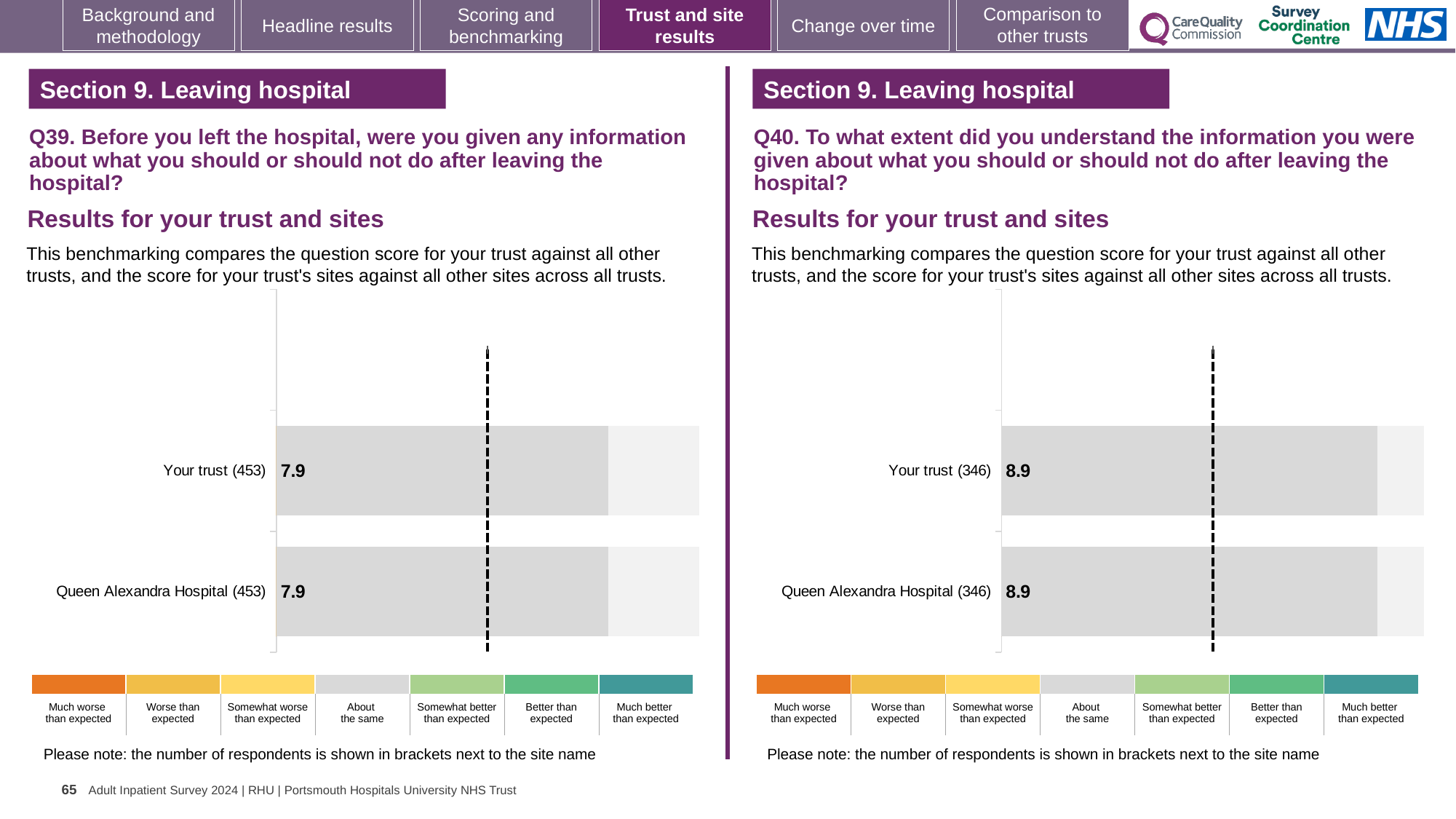
In the Q40 chart on the right, how many respondents are shown in brackets next to Queen Alexandra Hospital? 346 In the Q39 chart on the left, what is the score for Queen Alexandra Hospital? 7.9 In the Q40 chart on the right, what is the score for Your trust? 8.9 What kind of chart is the Q39 chart on the left? Bar chart In the Q40 chart on the right, how many bars are plotted? 2 In the Q39 chart on the left, what is the difference between the score for Your trust and the score for Queen Alexandra Hospital? 0 Is the score for Your trust in the Q40 chart on the right larger than the score for Your trust in the Q39 chart on the left? Yes What is the difference between the Your trust score in the Q40 chart on the right and the Your trust score in the Q39 chart on the left? 1.0 In the Q40 chart on the right, what is the score for Queen Alexandra Hospital? 8.9 In the Q39 chart on the left, how many respondents are shown in brackets next to Your trust? 453 In the Q39 chart on the left, what is the score for Your trust? 7.9